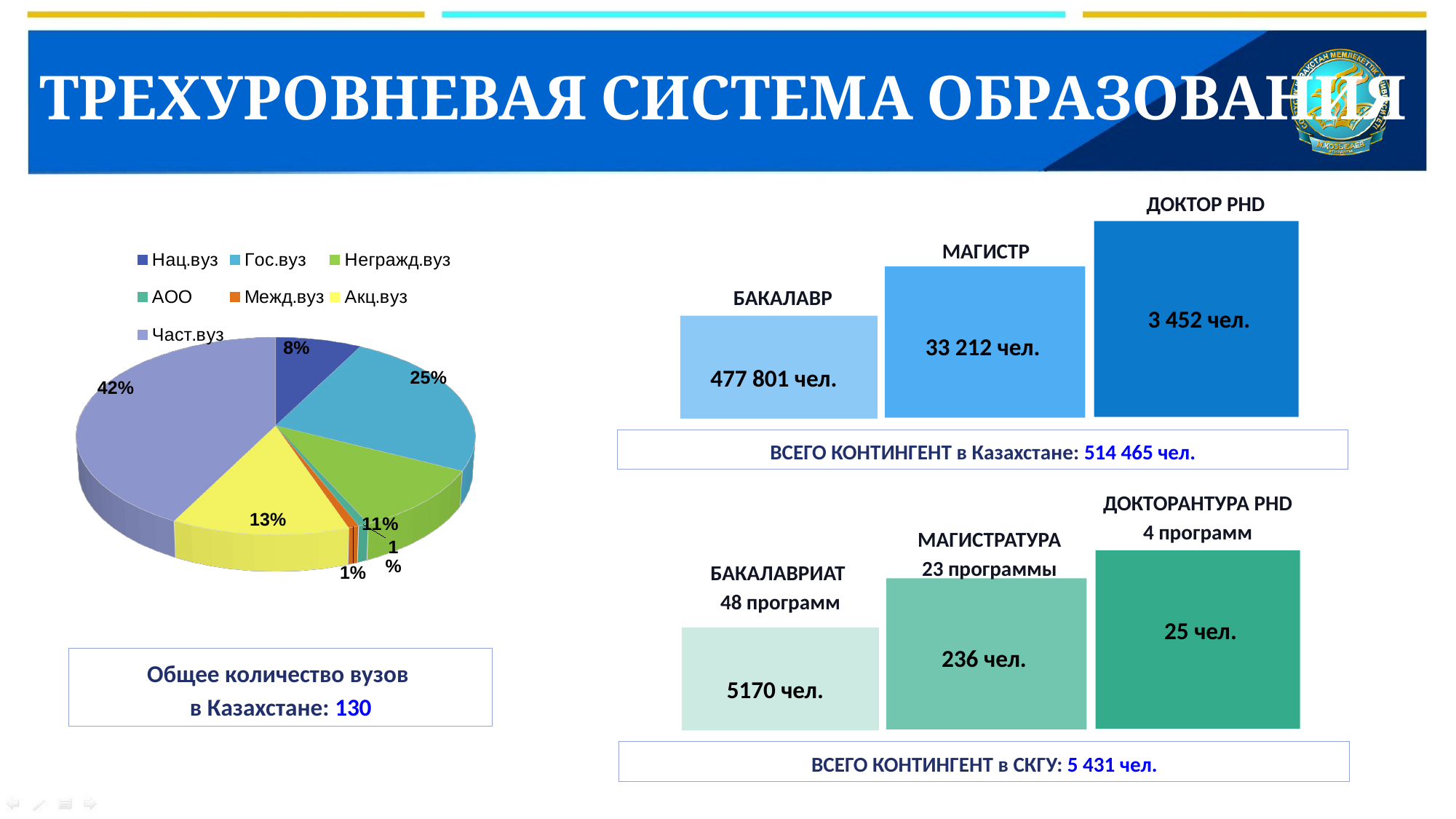
In the pie chart, how many percentage points larger is Част.вуз than Гос.вуз? 17% How many categories does the pie chart's legend list? 7 In the pie chart, what share is labelled for Част.вуз? 42% In the pie chart, which slice is larger: Гос.вуз or Акц.вуз? Гос.вуз In the pie chart, what share is labelled for Акц.вуз? 13% In the pie chart, what share is labelled for Гос.вуз? 25% In the pie chart, what share is labelled for Негражд.вуз? 11% Which category has the largest slice in the pie chart? Част.вуз In the pie chart, what share is labelled for Нац.вуз? 8% What colour is the Акц.вуз slice in the pie chart? yellow In the pie chart, how many percentage points larger is Акц.вуз than Нац.вуз? 5% What kind of chart is shown on the left side of the slide? pie chart